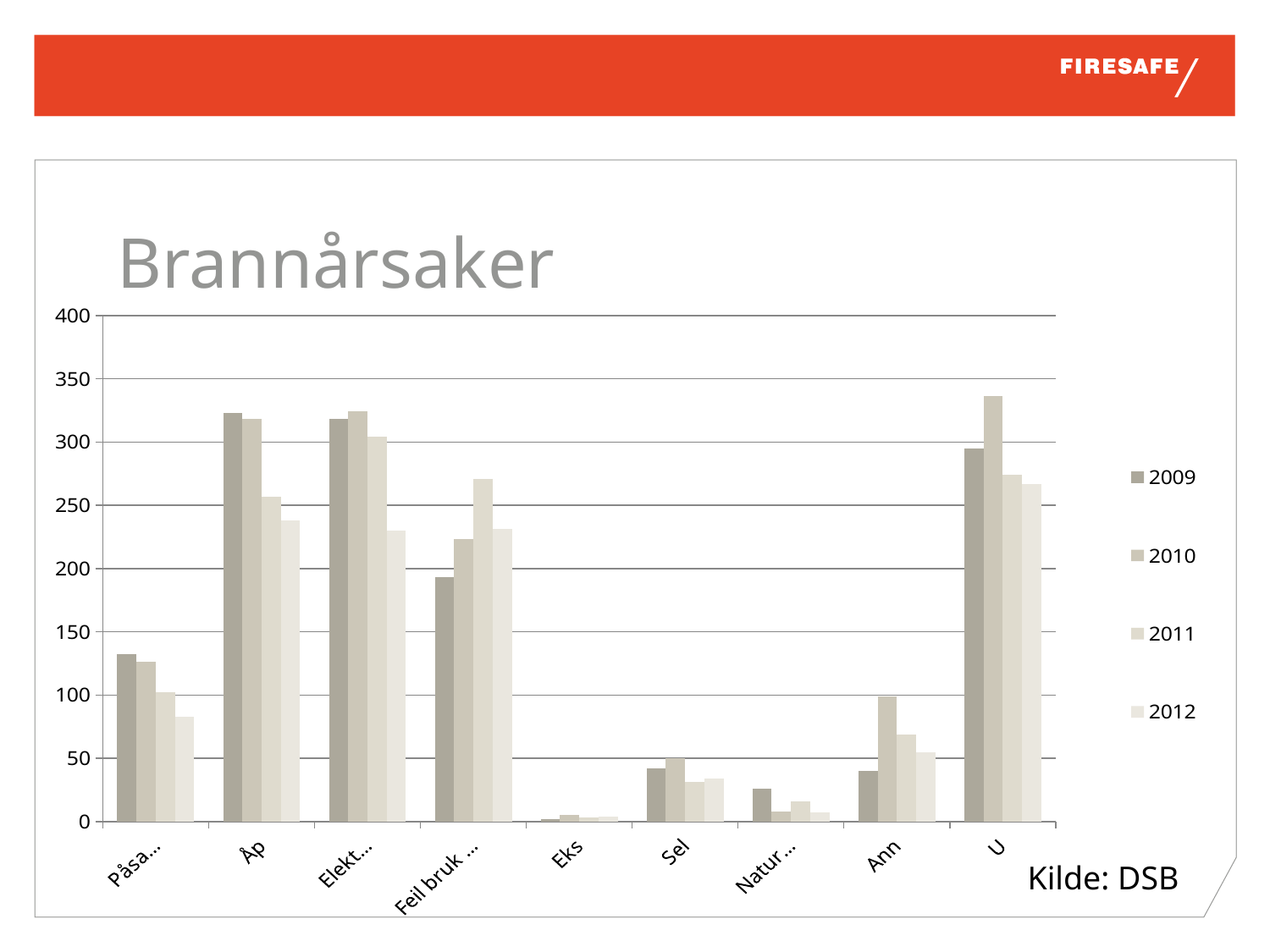
Which category has the highest value for 2010? U Is the 2010 value for Ann greater or less than 50? greater Which category has the lowest value for 2009? Eks For the category Åp, do the values rise or fall from 2009 to 2012? fall For the category Ann, which is larger: the 2009 value or the 2012 value? 2012 How many series does the legend list? 4 What is the title of the chart? Brannårsaker What kind of chart is shown on the slide? bar chart For the category Sel, which is larger: the 2010 value or the 2011 value? 2010 Is the 2012 value for U greater or less than 250? greater How many categories are shown on the x axis? 9 Is the 2009 value for Sel greater or less than 50? less